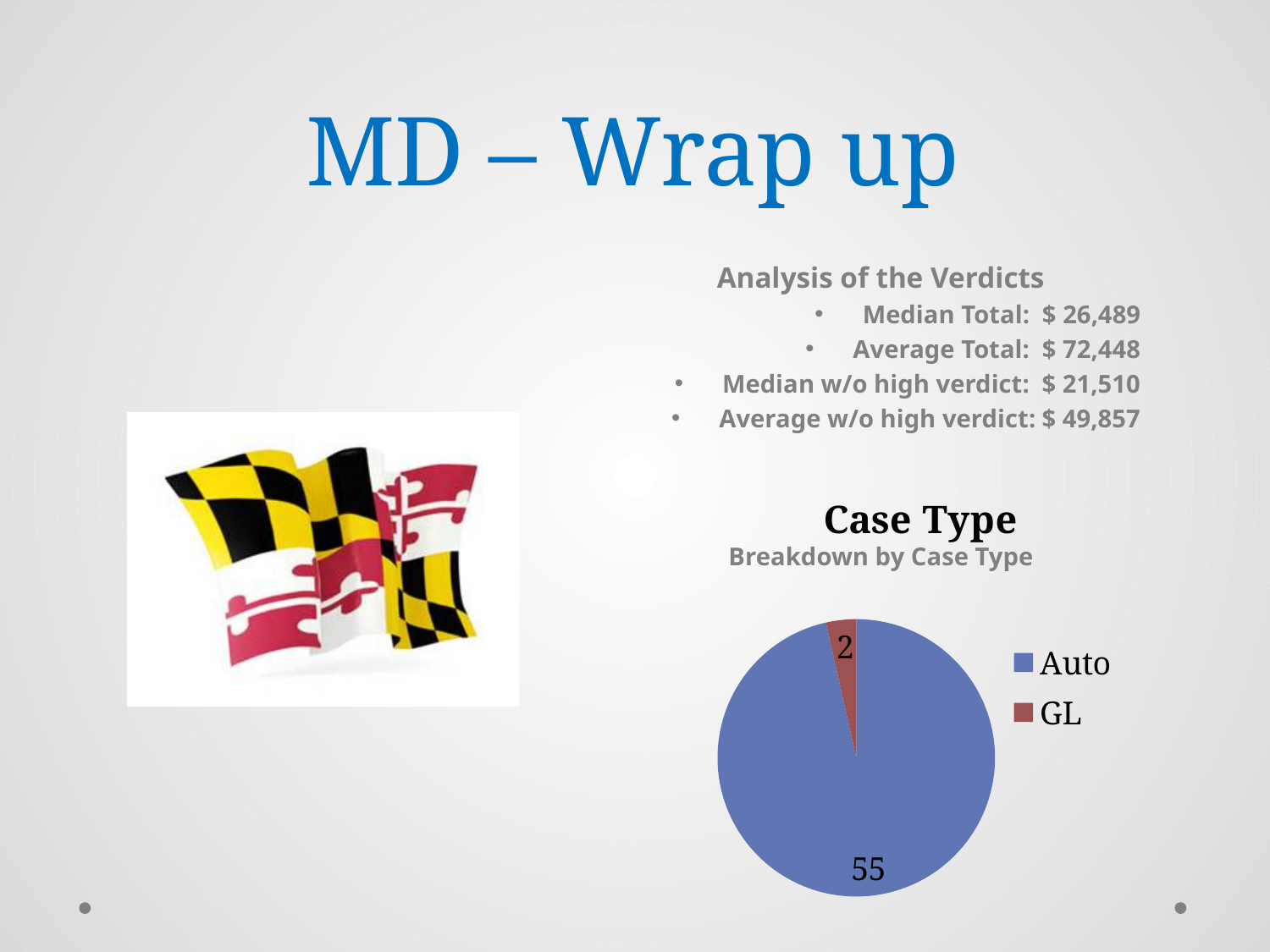
What is the value for Auto in the Case Type pie chart? 55 Which case type has the largest slice in the Case Type pie chart? Auto What kind of chart is shown under the title "Case Type"? pie chart Which is larger in the Case Type pie chart, Auto or GL? Auto How many entries does the legend of the Case Type pie chart list? 2 What is the total of all slices in the Case Type pie chart? 57 What is the difference between the Auto and GL values in the Case Type pie chart? 53 What is the value for GL in the Case Type pie chart? 2 What colour is the Auto slice in the Case Type pie chart? blue Which case type has the smallest slice in the Case Type pie chart? GL What is the title of the pie chart on the slide? Case Type How many slices does the Case Type pie chart have? 2